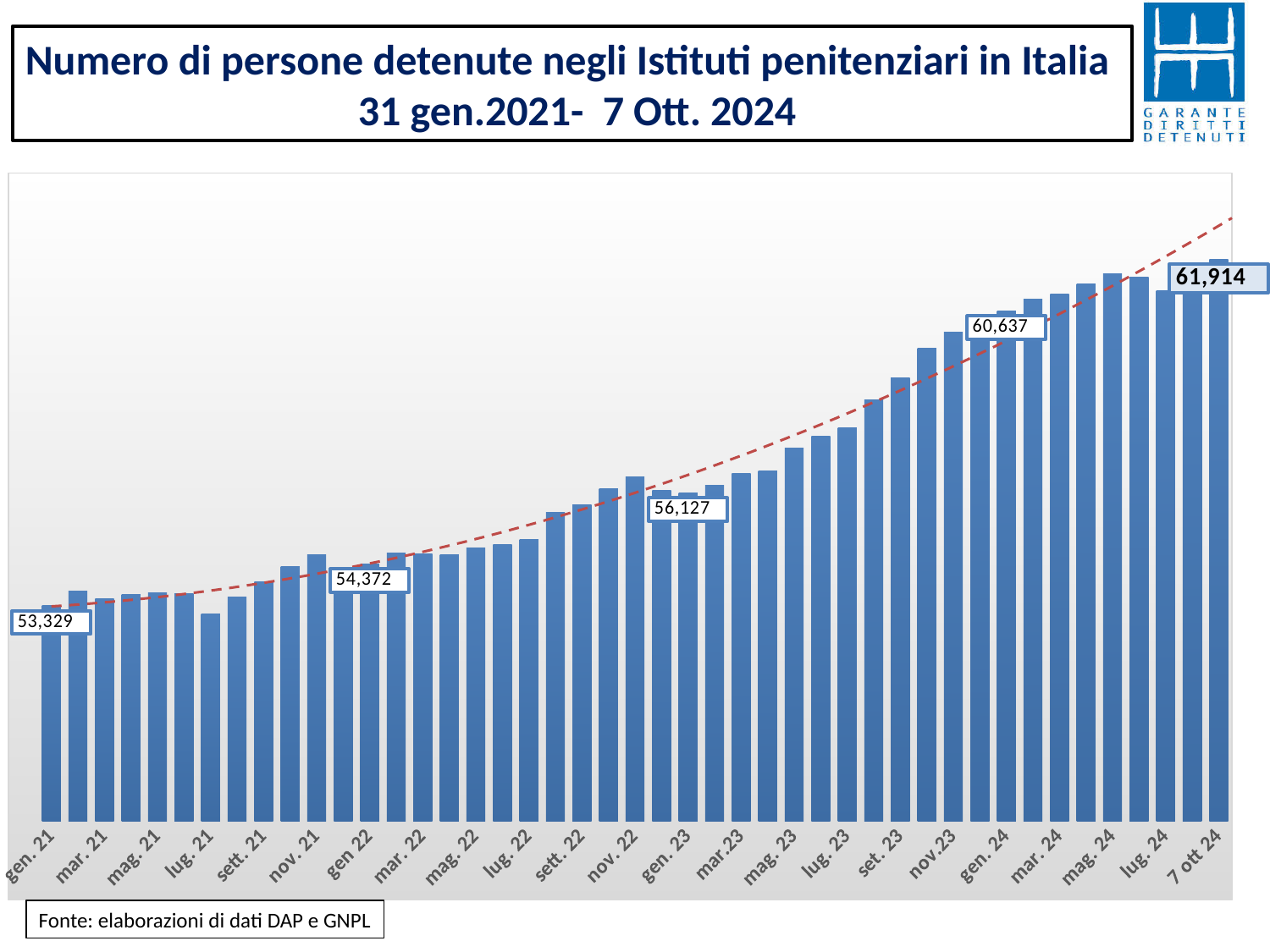
Which period has the highest bar in the chart? 7 ott 24 What value is labelled on the bar for gen. 23? 56,127 What kind of chart is shown on the slide? Bar chart By how much did the number of detained persons increase between gen. 21 (53,329) and 7 ott 24 (61,914)? 8,585 What is the number of detained persons shown for 7 ott 24? 61,914 What is the difference between the labelled values for gen. 24 and gen. 23? 4,510 What value is labelled on the bar for gen. 24? 60,637 Which of the labelled values is larger, gen. 24 or gen. 23? gen. 24 What value is labelled on the bar for gen. 22? 54,372 Do the values generally rise or fall from gen. 21 to 7 ott 24? Rise What is the source cited below the chart? Fonte: elaborazioni di dati DAP e GNPL What is the number of detained persons shown for gen. 21? 53,329